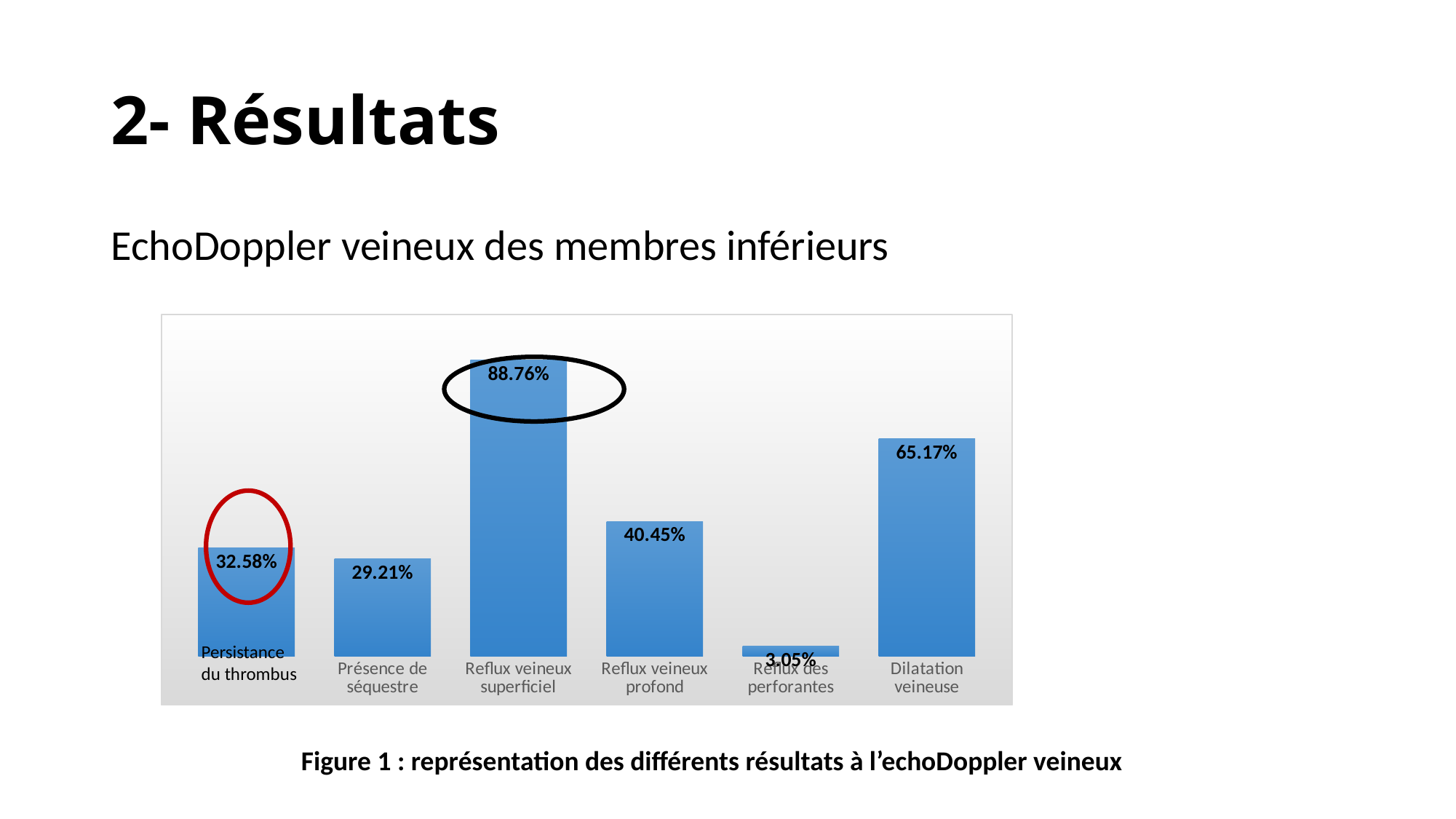
What is the value for Présence de séquestre? 29.21% Which category has the highest value? Reflux veineux superficiel What is the value for Dilatation veineuse? 65.17% Which is larger, Reflux veineux profond or Persistance du thrombus? Reflux veineux profond How many categories are shown in the chart? 6 What is the value for Reflux des perforantes? 3.05% What is the difference between Persistance du thrombus and Présence de séquestre? 3.37% What is the caption of the figure below the chart? Figure 1 : représentation des différents résultats à l’echoDoppler veineux What is the difference between Reflux veineux superficiel and Dilatation veineuse? 23.59% What is the value for Reflux veineux superficiel? 88.76% What kind of chart is shown on the slide? Bar chart Which category has the lowest value? Reflux des perforantes